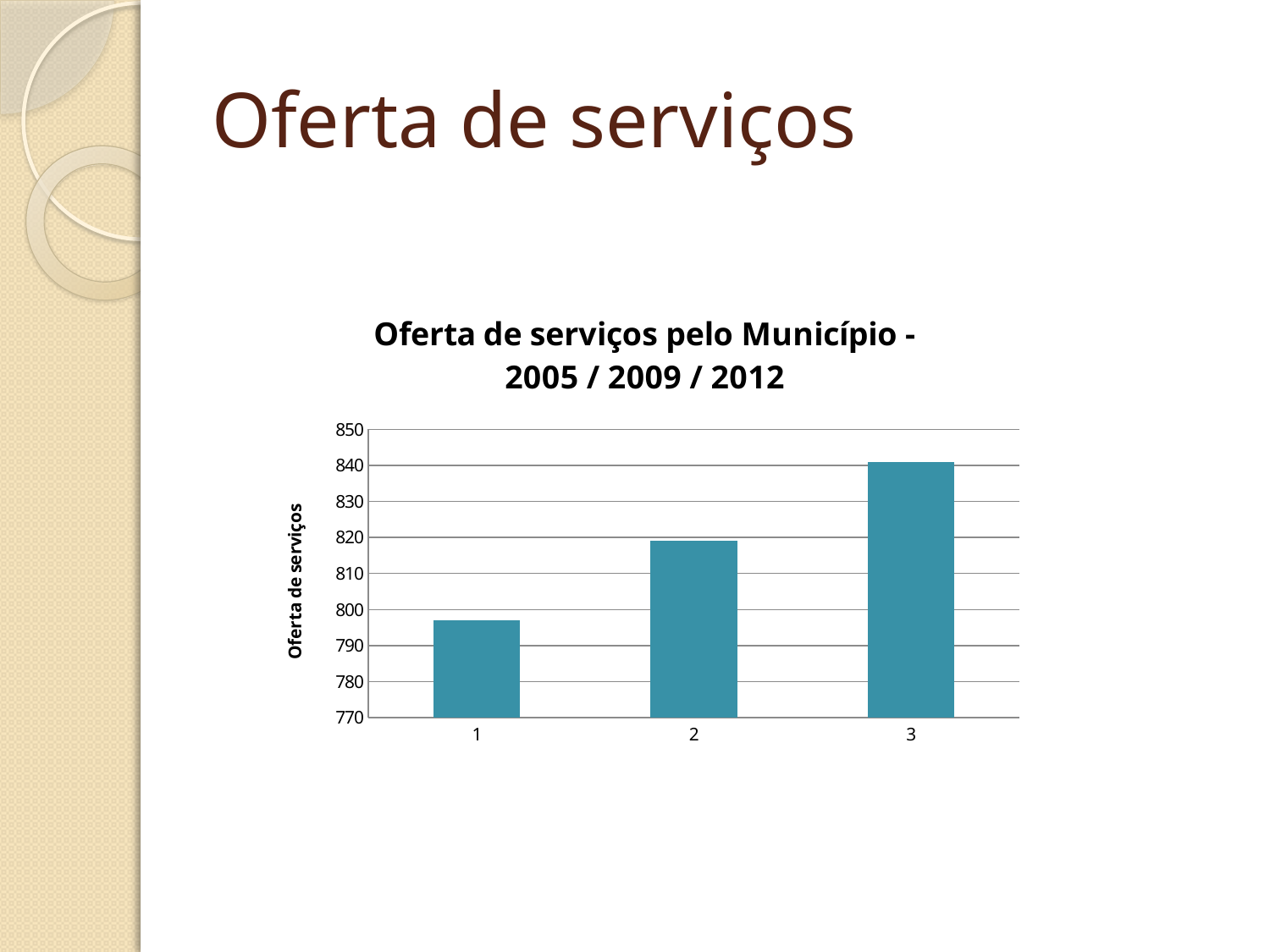
What kind of chart is shown on the slide? bar chart How many bars are plotted in the chart? 3 Is the value for category 1 greater or less than 790? greater Which category has the lowest bar? 1 Is the value for category 2 greater or less than 810? greater What is the label of the vertical axis? Oferta de serviços Which is larger, the value for category 1 or the value for category 2? 2 Is the value for category 1 greater or less than 810? less What is the title of the chart? Oferta de serviços pelo Município - 2005 / 2009 / 2012 Do the values rise or fall from category 1 to category 3? rise Which category has the highest bar? 3